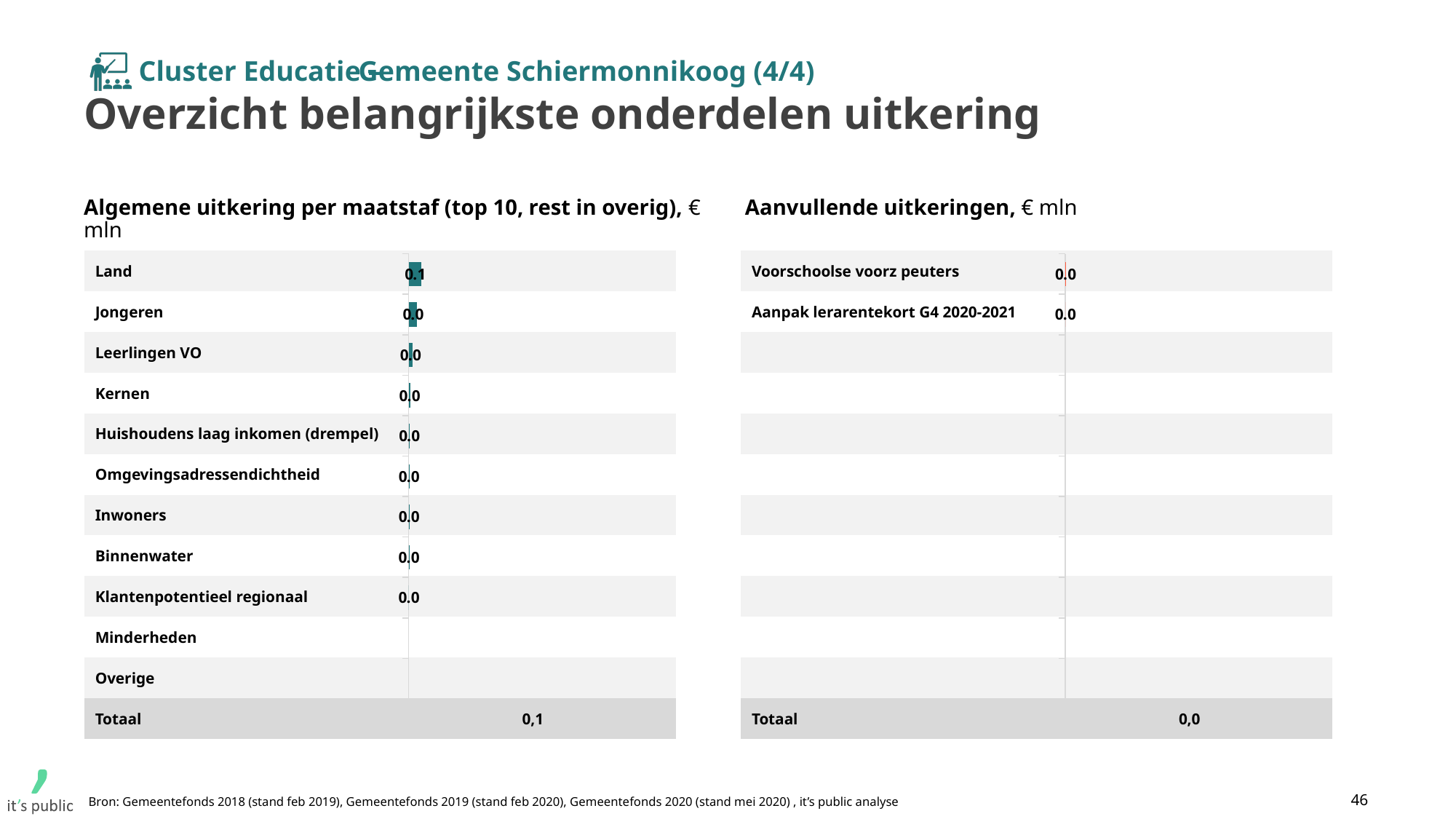
In the chart 'Algemene uitkering per maatstaf', what is the Totaal value? 0,1 In the chart 'Aanvullende uitkeringen', what is the value for Aanpak lerarentekort G4 2020-2021? 0.0 In the chart 'Algemene uitkering per maatstaf', which category has the highest value? Land In the chart 'Algemene uitkering per maatstaf', what is the value for Land? 0.1 What kind of chart is the 'Algemene uitkering per maatstaf' chart? Bar chart In the chart 'Algemene uitkering per maatstaf', what is the value for Jongeren? 0.0 In the chart 'Aanvullende uitkeringen', what is the Totaal value? 0,0 In the chart 'Algemene uitkering per maatstaf', what is the difference between the values for Land and Jongeren? 0.1 In the chart 'Aanvullende uitkeringen', how many categories have a value shown (excluding Totaal)? 2 In the chart 'Aanvullende uitkeringen', what is the value for Voorschoolse voorz peuters? 0.0 In the chart 'Algemene uitkering per maatstaf', what is the value for Klantenpotentieel regionaal? 0.0 In the chart 'Algemene uitkering per maatstaf', how many categories are listed (excluding Totaal)? 11